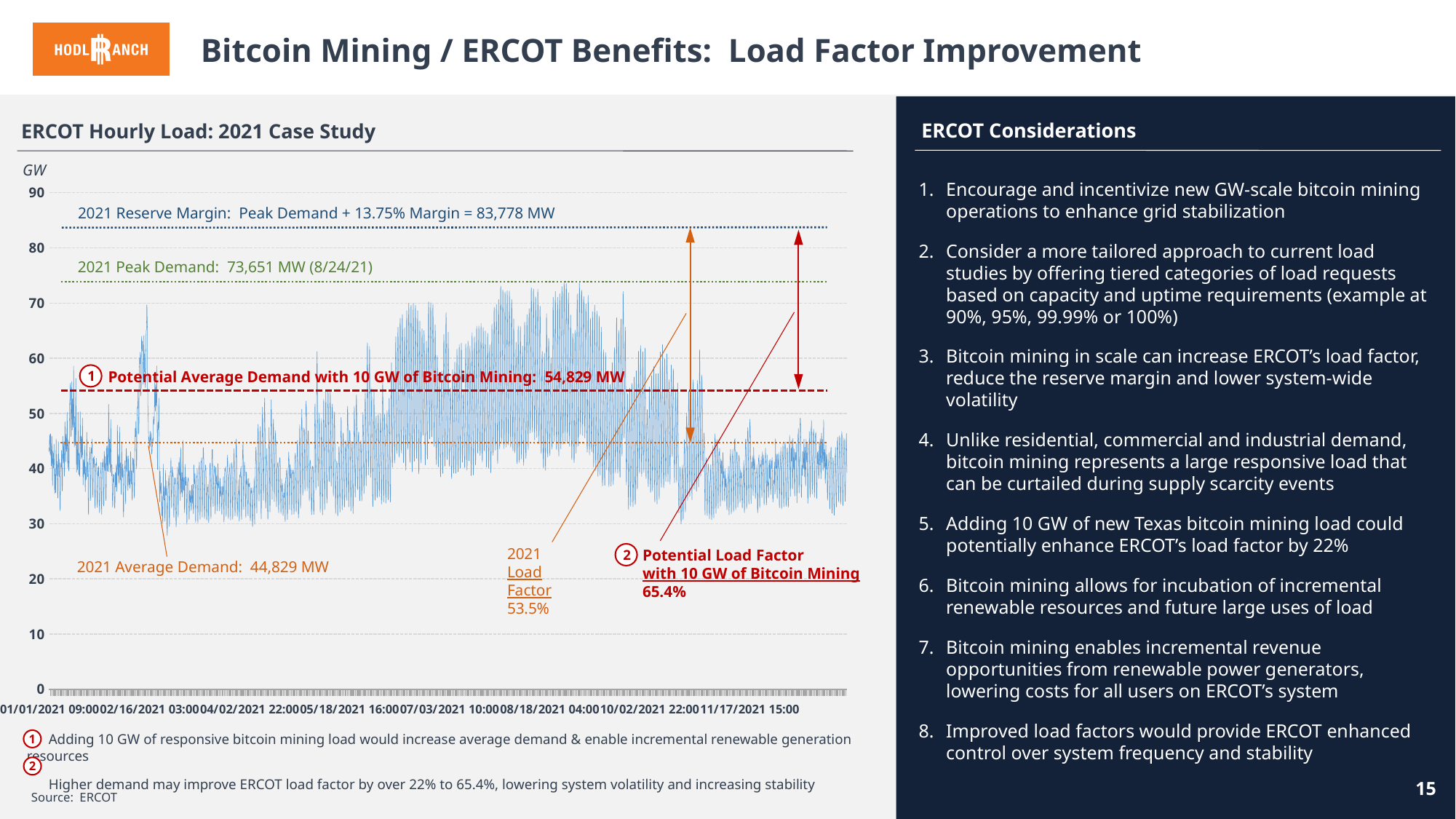
What was the 2021 Peak Demand according to the chart annotation? 73,651 MW What is the Potential Load Factor with 10 GW of Bitcoin Mining shown on the chart? 65.4% What was the 2021 Average Demand shown on the chart? 44,829 MW What is the 2021 Reserve Margin value shown on the chart? 83,778 MW What unit is shown on the y axis of the ERCOT Hourly Load chart? GW What is the title of the chart on the slide? ERCOT Hourly Load: 2021 Case Study What type of chart is used to show the ERCOT hourly load? line chart What is the 2021 Load Factor shown on the chart? 53.5% Which is larger, the 2021 Peak Demand or the 2021 Reserve Margin? 2021 Reserve Margin By how much does the Potential Average Demand with 10 GW of Bitcoin Mining exceed the 2021 Average Demand? 10,000 MW What is the Potential Average Demand with 10 GW of Bitcoin Mining shown on the chart? 54,829 MW What is the difference between the 2021 Reserve Margin and the 2021 Peak Demand? 10,127 MW